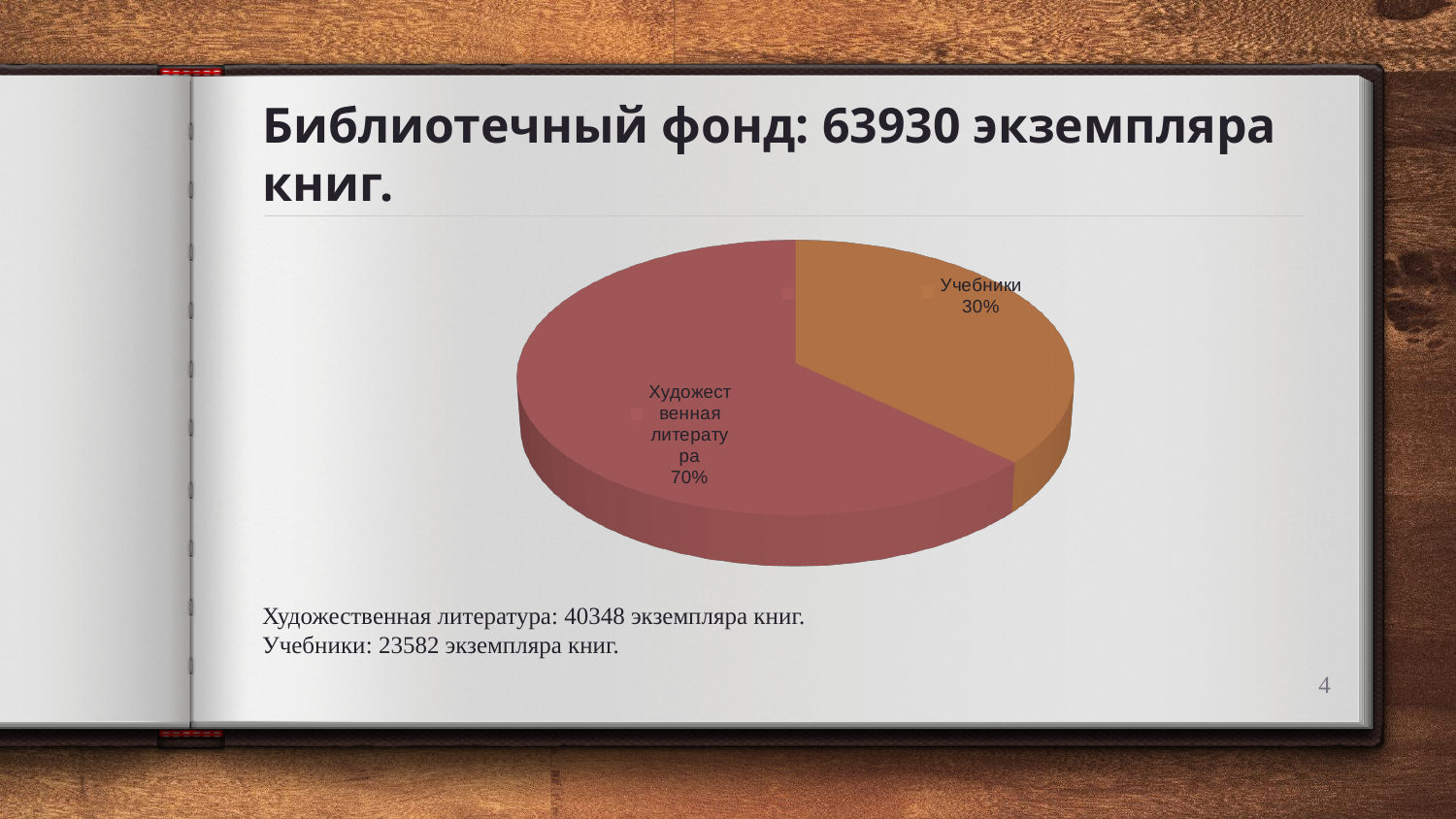
What is the difference in percentage points between the Художественная литература slice and the Учебники slice? 40% How many slices does the pie chart have? 2 What kind of chart is shown on the slide? pie chart What share of the pie does Художественная литература represent? 70% What share of the pie does Учебники represent? 30% What colour is the Художественная литература slice? red Which slice of the pie is the smallest? Учебники Which is larger: the Учебники slice or the Художественная литература slice? Художественная литература Which slice of the pie is the largest? Художественная литература What colour is the Учебники slice? orange